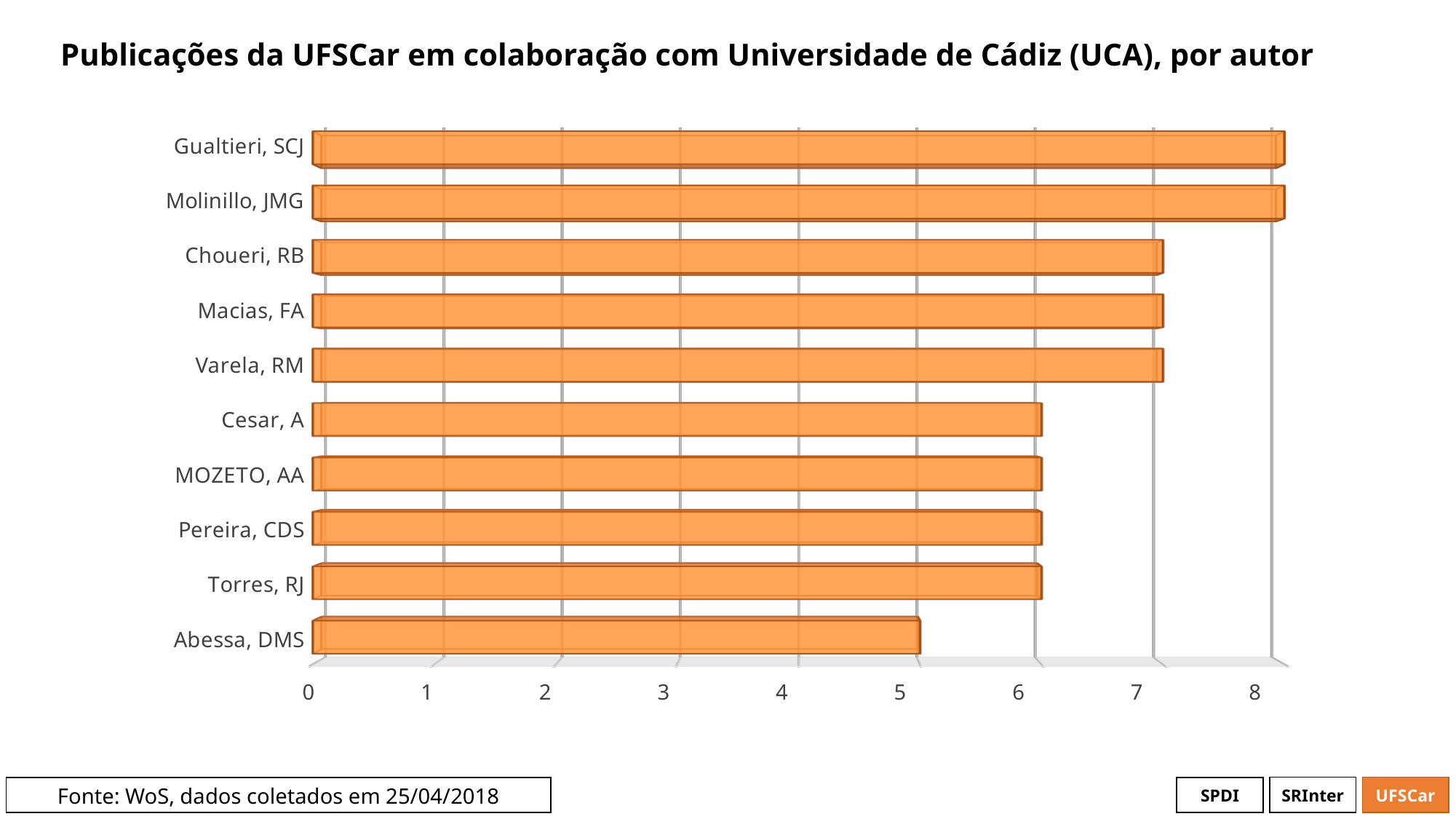
Which has a larger value, Abessa, DMS or Pereira, CDS? Pereira, CDS Which author has the lowest number of publications on the chart? Abessa, DMS What kind of chart is shown on the slide? bar chart Is the value for Torres, RJ greater or less than 5? greater What is the title of the chart? Publicações da UFSCar em colaboração com Universidade de Cádiz (UCA), por autor How many authors are listed on the chart? 10 Is the value for Abessa, DMS greater or less than 6? less Is the value for Gualtieri, SCJ greater or less than 7? greater Which has a larger value, Choueri, RB or Cesar, A? Choueri, RB What colour are the bars in the chart? orange